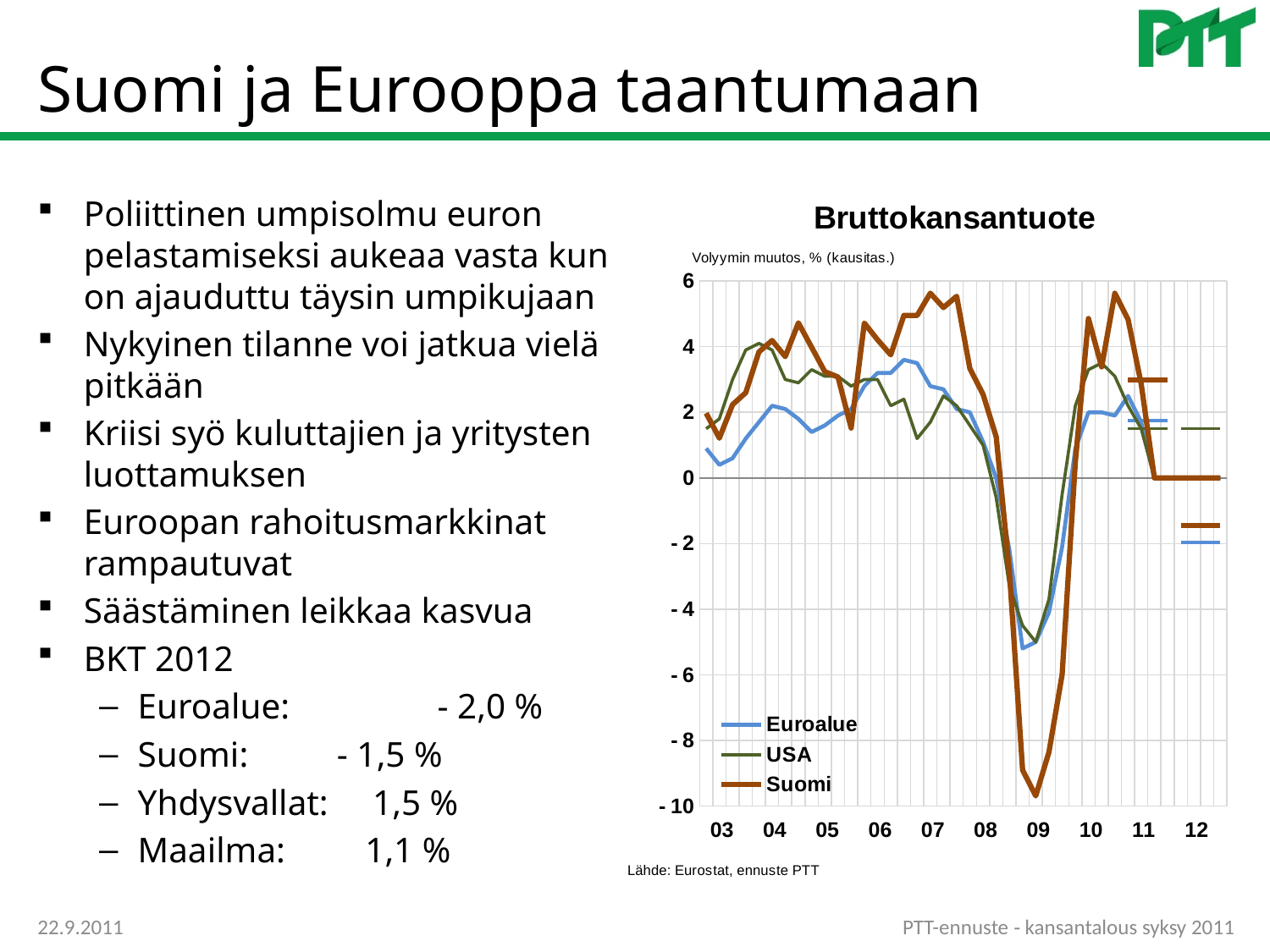
Do the values of all three series rise or fall between 2008 and early 2009? fall Is the lowest value of the Euroalue series in 2009 greater or less than -4? less Which series are listed in the legend of the Bruttokansantuote chart? Euroalue, USA, Suomi How many years are labelled on the x axis of the Bruttokansantuote chart? 10 What is the title of the chart on the slide? Bruttokansantuote Which series reaches the highest peak in the Bruttokansantuote chart? Suomi What kind of chart is shown on the slide? line chart Is the lowest value of the Suomi series in 2009 greater or less than -8? less In 2007, which series has the higher value, Suomi or Euroalue? Suomi Is the peak of the Suomi series in 2007 greater or less than 4? greater How many series does the legend of the Bruttokansantuote chart list? 3 Which series reaches the lowest value in the Bruttokansantuote chart? Suomi